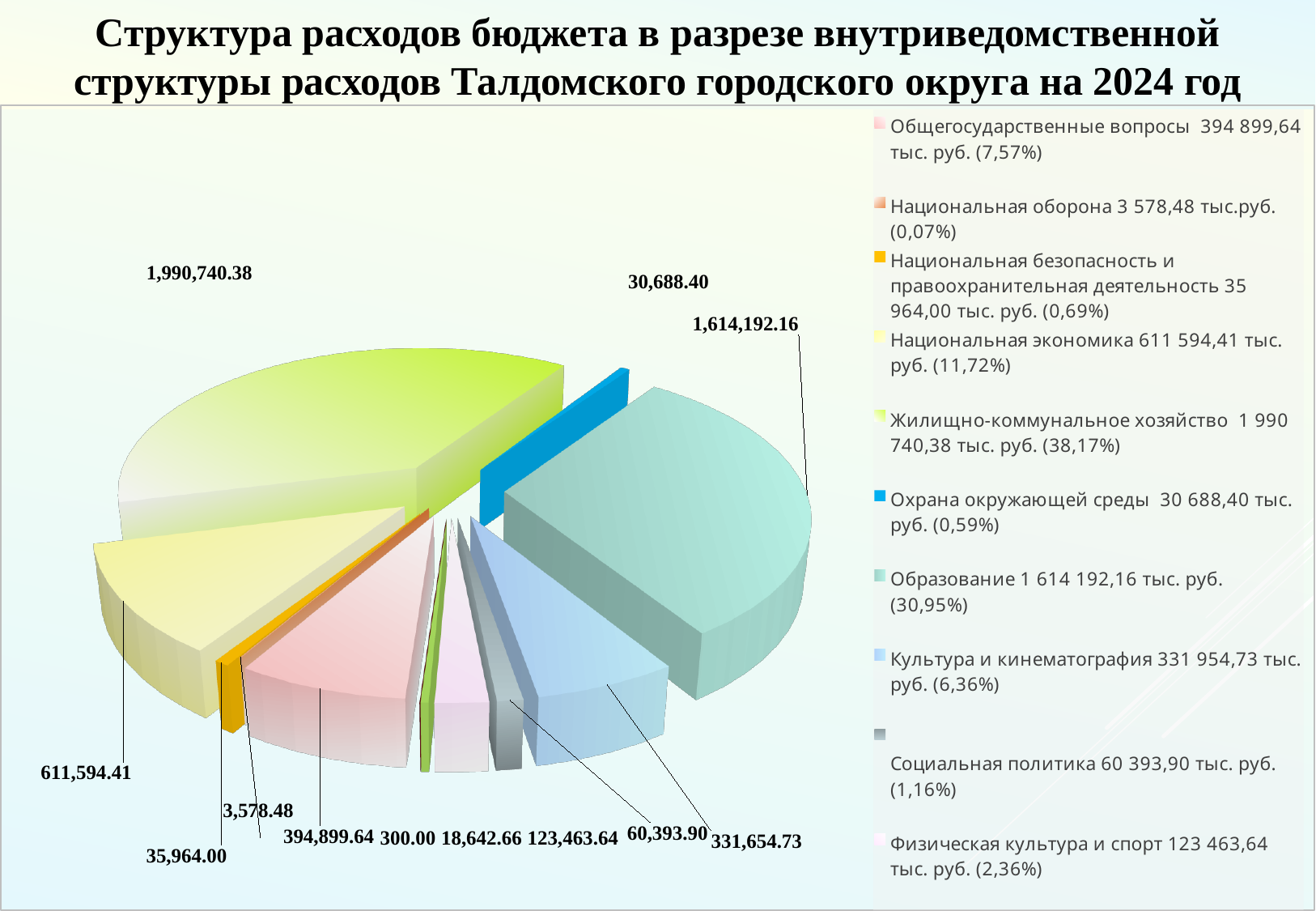
What is the value shown for Социальная политика? 60,393.90 What is the value shown for Национальная оборона? 3,578.48 What is the smallest value printed as a data label on the pie chart? 300.00 According to the legend, what share of the pie does Образование represent? 30,95% What is the value shown for Физическая культура и спорт? 123,463.64 How many data labels are printed on the pie chart? 12 Which category has the largest slice of the pie? Жилищно-коммунальное хозяйство What is the value shown for Охрана окружающей среды? 30,688.40 What is the difference between the values for Жилищно-коммунальное хозяйство and Образование? 376,548.22 What kind of chart is shown on the slide? pie chart What is the value shown for Жилищно-коммунальное хозяйство? 1,990,740.38 Which is larger: Национальная экономика or Общегосударственные вопросы? Национальная экономика